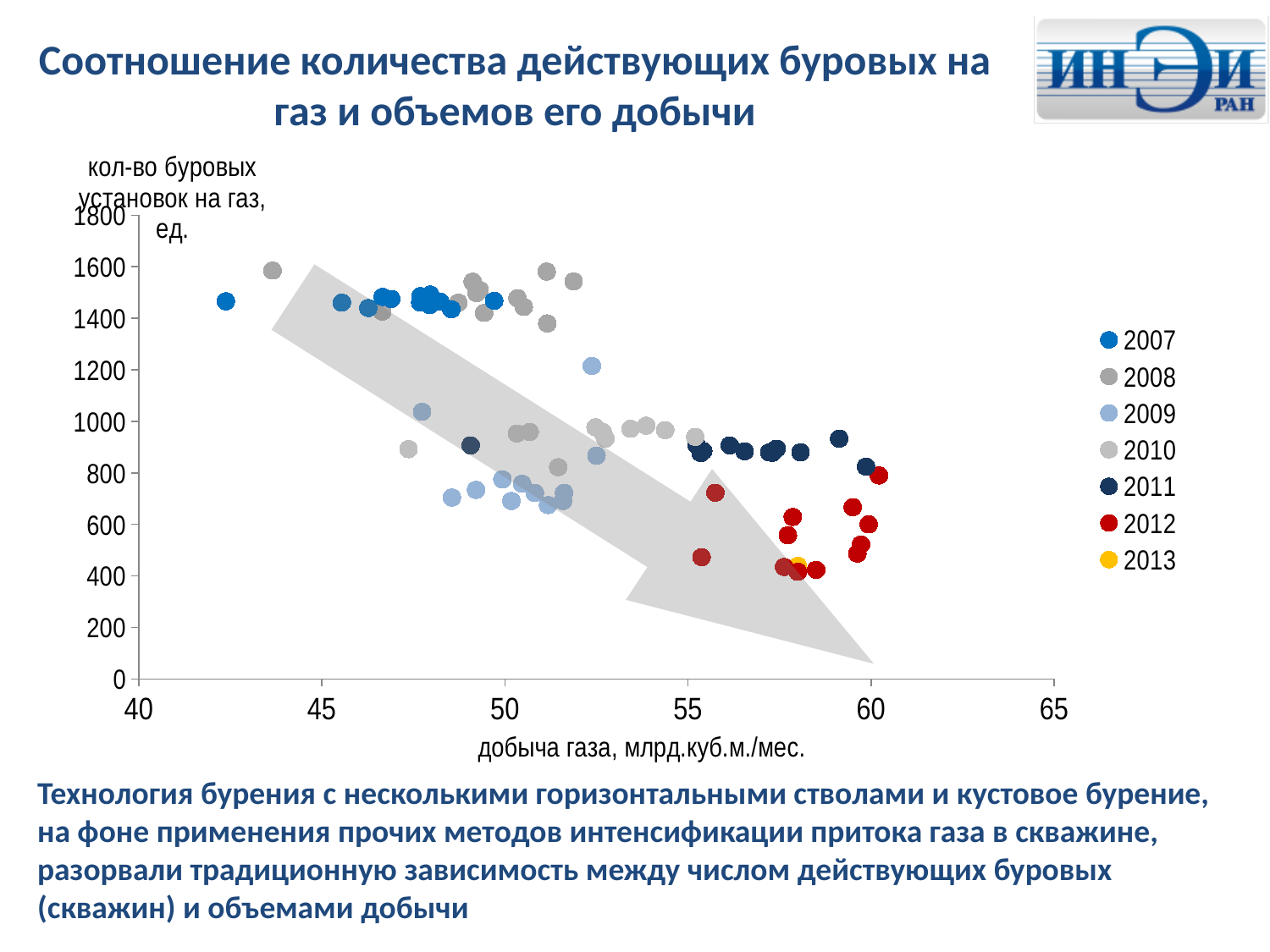
What is the maximum value shown on the y axis? 1800 How many series does the legend list? 7 What kind of chart is shown on the slide? scatter chart As gas production increases along the x axis, does the number of drilling rigs generally rise or fall? fall Which years are listed in the legend? 2007, 2008, 2009, 2010, 2011, 2012, 2013 Is the value for the 2013 point greater or less than 600? less Are the values for the 2011 series greater or less than 1200? less What is the label of the x axis? добыча газа, млрд.куб.м./мес. Are the values for the 2012 series greater or less than 1000? less Which series has the lowest number of drilling rigs, 2013 or 2011? 2013 Which series has points with the highest number of drilling rigs, 2007 or 2012? 2007